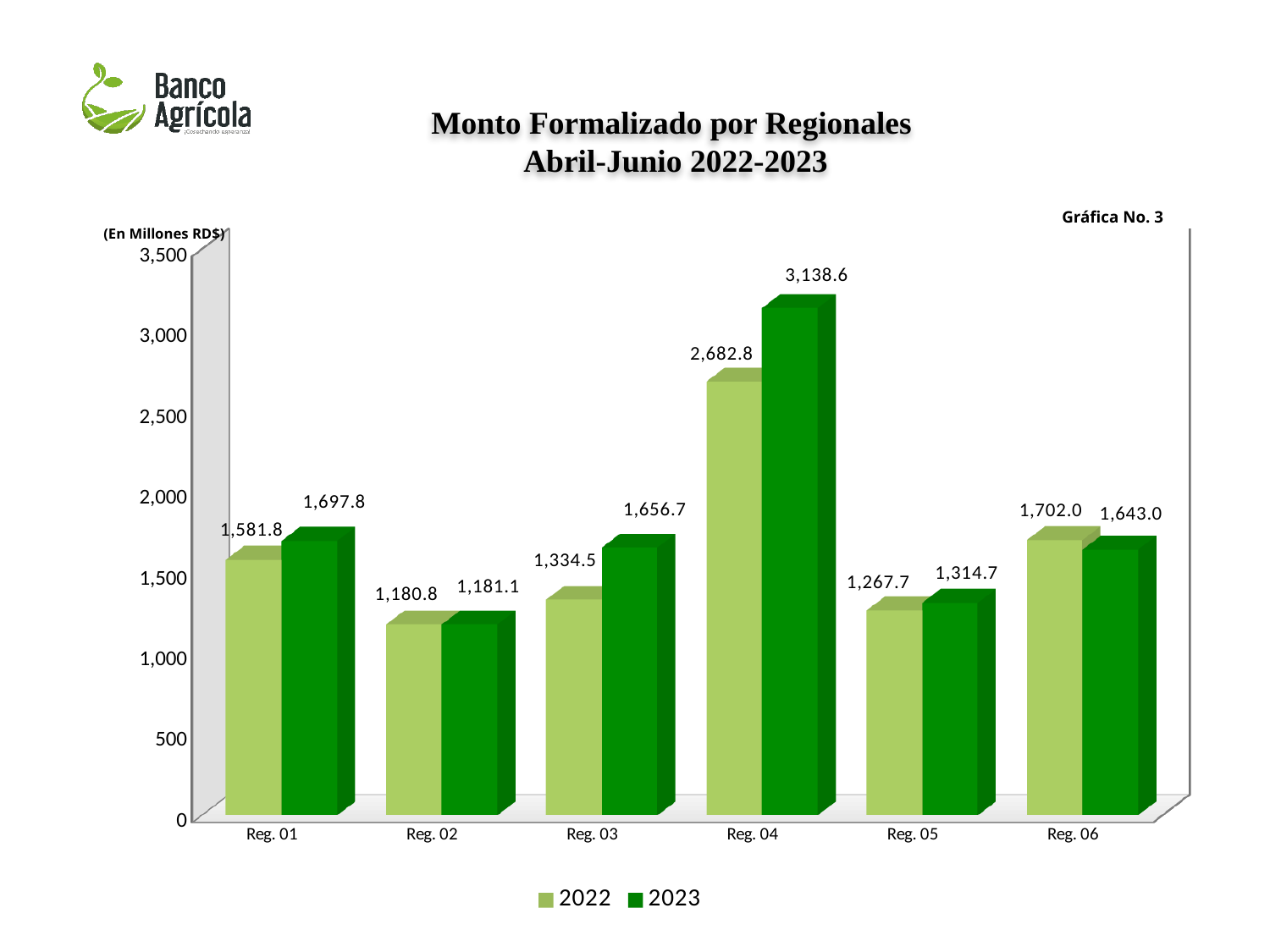
Which region has the lowest 2022 value? Reg. 02 For Reg. 06, which is larger, the 2022 value or the 2023 value? 2022 How many series does the legend list? 2 What kind of chart is shown on the slide? Bar chart How many regions are shown on the x axis? 6 What is the 2023 value for Reg. 04? 3,138.6 Which region has the highest 2023 value? Reg. 04 What is the 2023 value for Reg. 05? 1,314.7 What is the difference between the 2023 and 2022 values for Reg. 04? 455.8 Is the 2022 value for Reg. 04 greater or less than 2,500? greater What is the difference between the 2022 and 2023 values for Reg. 06? 59.0 What is the 2022 value for Reg. 03? 1,334.5